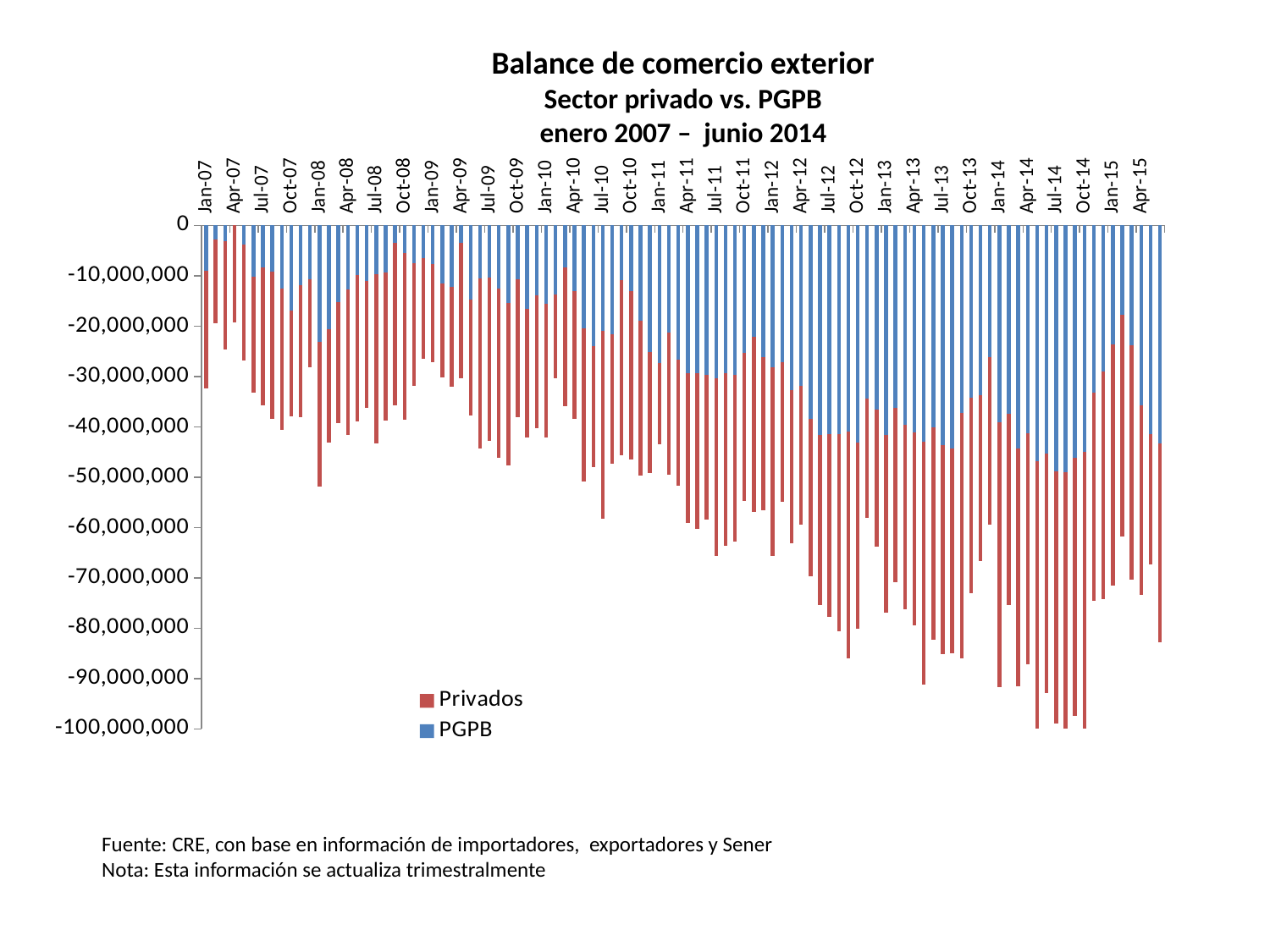
How many series does the legend list? 2 What is the last period label on the horizontal axis? Apr-15 Is the stacked total for Jan-07 greater or less than -40,000,000? greater What is the lowest value shown on the vertical axis? -100,000,000 Is the stacked total for Jan-07 greater or less than -20,000,000? less What is the first period label on the horizontal axis? Jan-07 What kind of chart is shown on the slide? Stacked bar chart Which series, Privados or PGPB, accounts for the larger share of the stacked bars across the chart? Privados Do the stacked totals generally rise or fall (become more negative) from Jan-07 to Apr-15? Fall